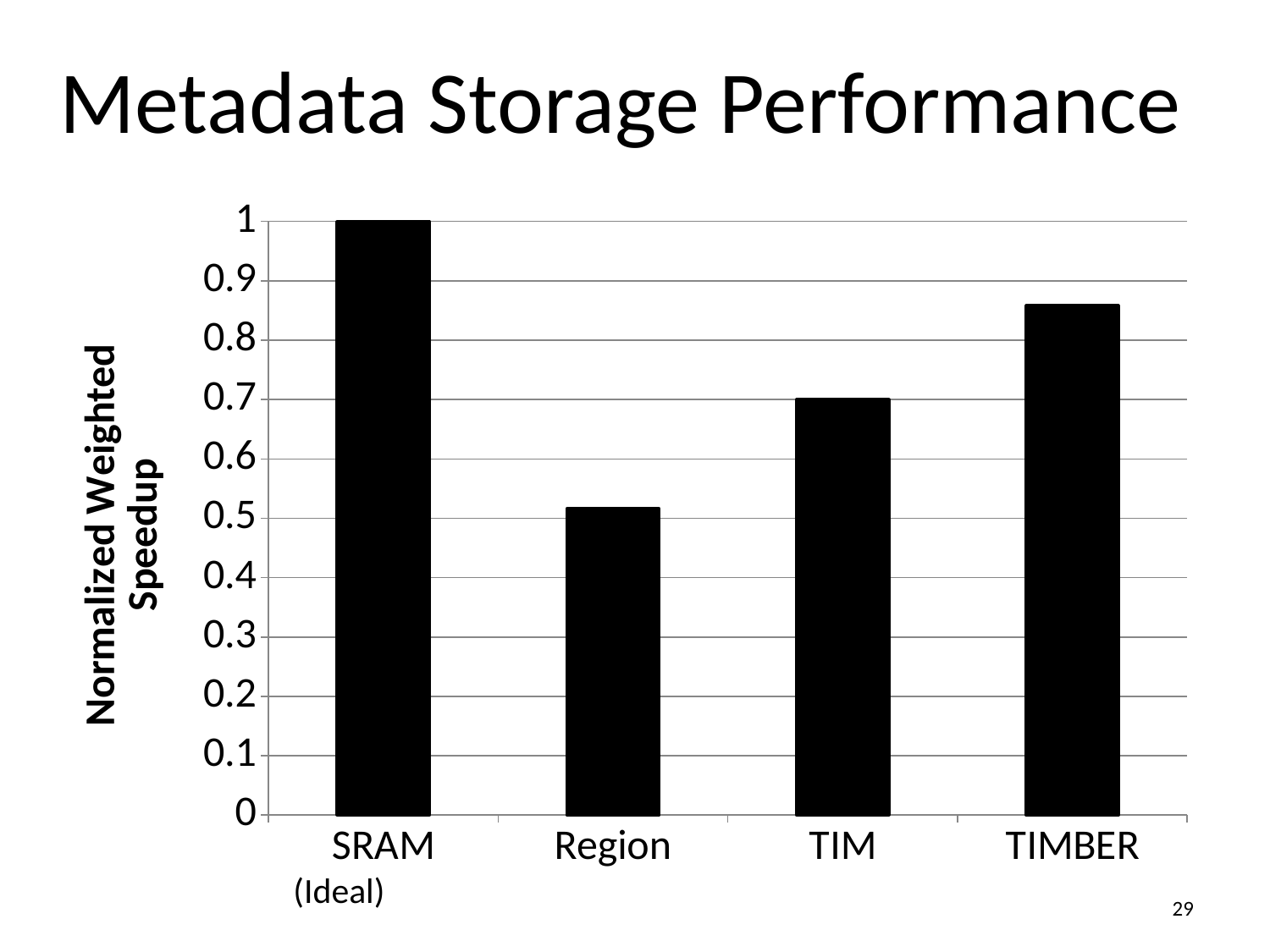
Which category has the highest normalized weighted speedup? SRAM (Ideal) Is the value for Region greater or less than 0.6? less How many categories are plotted on the x axis? 4 What is the title of the slide containing the chart? Metadata Storage Performance Which has a higher normalized weighted speedup, Region or TIM? TIM What is the label of the y axis? Normalized Weighted Speedup Is the value for TIM greater or less than 0.6? greater Which category has the lowest normalized weighted speedup? Region What kind of chart is shown on the slide? bar chart Is the value for TIMBER greater or less than 0.8? greater Which has a higher normalized weighted speedup, TIM or TIMBER? TIMBER What is the normalized weighted speedup for SRAM (Ideal)? 1